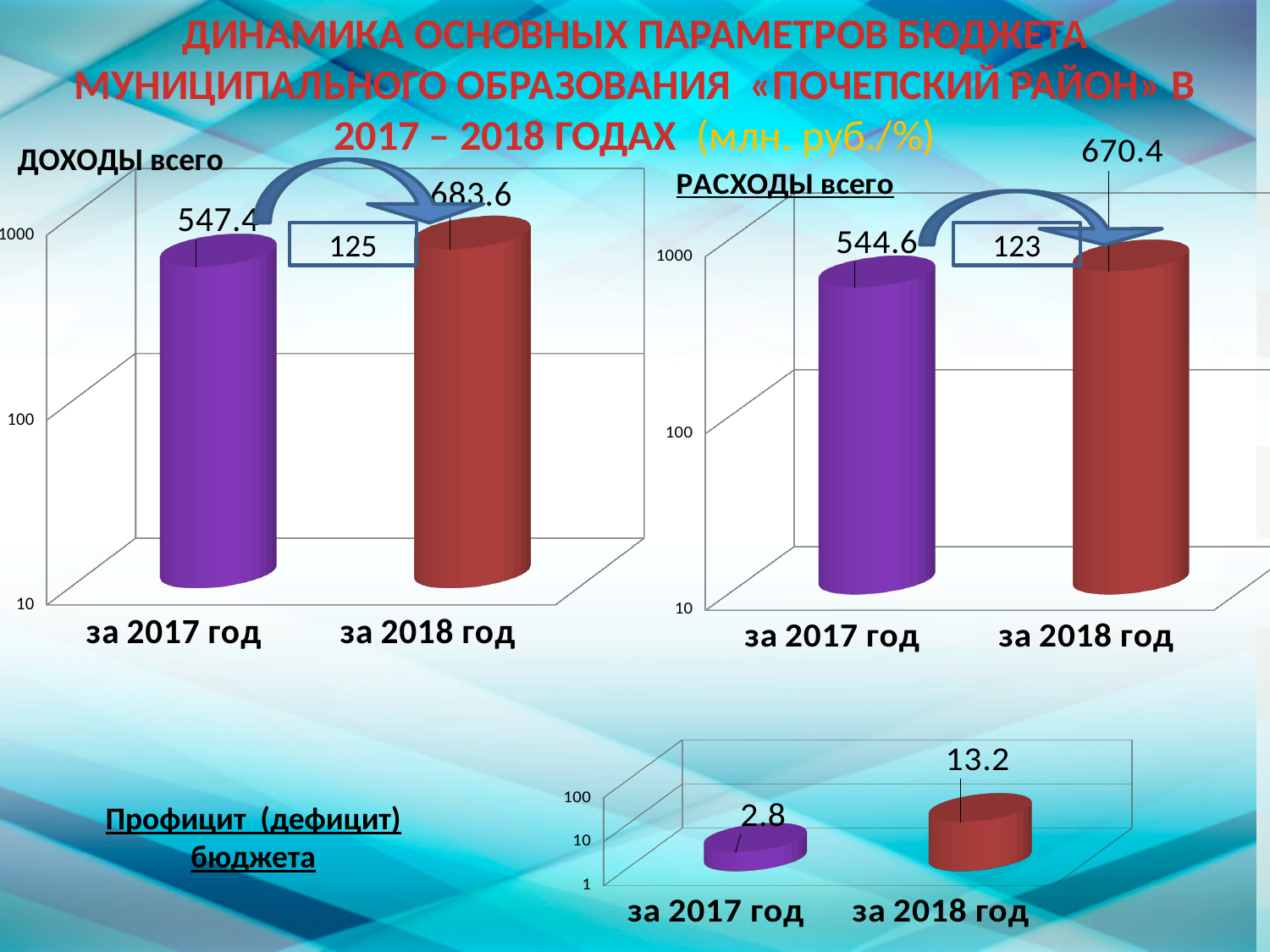
In the 'Профицит (дефицит) бюджета' chart, what is the value for 'за 2018 год'? 13.2 In the 'ДОХОДЫ всего' chart, what is the value for 'за 2017 год'? 547.4 In the 'Профицит (дефицит) бюджета' chart, which year has the higher value? за 2018 год In the 'ДОХОДЫ всего' chart, what percentage is shown in the box between the two bars? 125 What kind of chart is the 'РАСХОДЫ всего' chart? bar chart In the 'РАСХОДЫ всего' chart, what is the difference between the 2018 and 2017 values? 125.8 In the 'Профицит (дефицит) бюджета' chart, what is the value for 'за 2017 год'? 2.8 In the 'РАСХОДЫ всего' chart, what is the value for 'за 2017 год'? 544.6 In the 'ДОХОДЫ всего' chart, what is the value for 'за 2018 год'? 683.6 In the 'РАСХОДЫ всего' chart, what is the value for 'за 2018 год'? 670.4 In the 'ДОХОДЫ всего' chart, what is the difference between the 2018 and 2017 values? 136.2 In the 'ДОХОДЫ всего' chart, do the values rise or fall from 2017 to 2018? rise